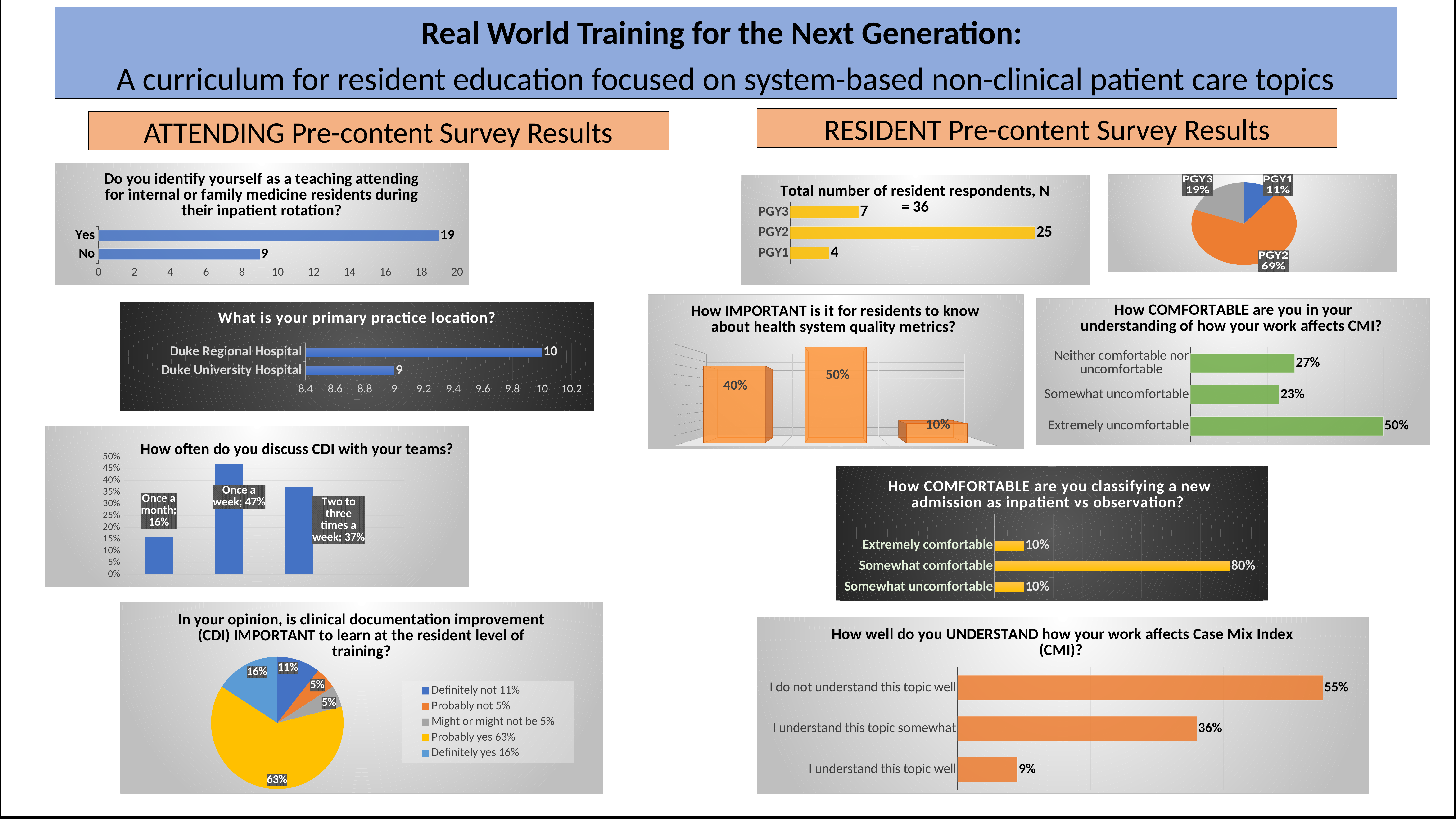
In the chart 'Do you identify yourself as a teaching attending...', what is the difference between the Yes and No values? 10 In the chart 'What is your primary practice location?', which location has the higher value? Duke Regional Hospital In the pie chart 'In your opinion, is clinical documentation improvement (CDI) IMPORTANT to learn at the resident level of training?', what share is 'Probably yes'? 63% In the chart 'Total number of resident respondents, N = 36', which category has the lowest value? PGY1 In the chart 'How often do you discuss CDI with your teams?', what is the value for 'Once a week'? 47% In the chart 'How well do you UNDERSTAND how your work affects Case Mix Index (CMI)?', what is the value for 'I understand this topic somewhat'? 36% In the pie chart about whether CDI is important to learn at the resident level, how many entries does the legend list? 5 In the pie chart showing PGY1, PGY2 and PGY3 shares, what share is PGY3? 19% In the chart 'Total number of resident respondents, N = 36', what is the value for PGY2? 25 In the chart 'Do you identify yourself as a teaching attending for internal or family medicine residents during their inpatient rotation?', what is the value for Yes? 19 In the chart 'How often do you discuss CDI with your teams?', how many categories are plotted? 3 In the chart 'How COMFORTABLE are you in your understanding of how your work affects CMI?', which category has the highest value? Extremely uncomfortable